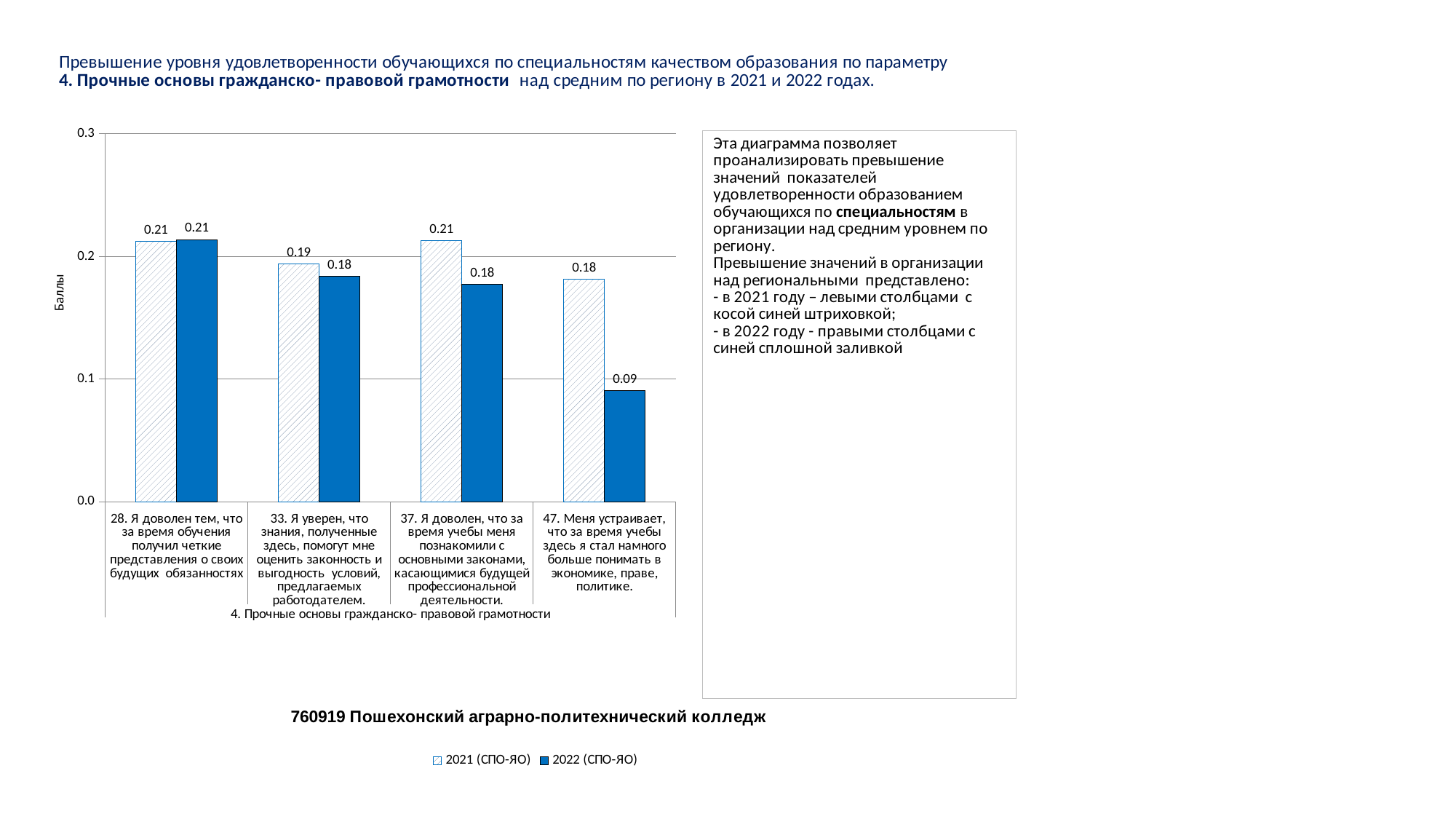
How many categories (questions) are shown on the x axis? 4 Which category has the lowest value for the 2022 (СПО-ЯО) series? 47. Меня устраивает, что за время учебы здесь я стал намного больше понимать в экономике, праве, политике. What is the value for 2022 (СПО-ЯО) for category 37 (Я доволен, что за время учебы меня познакомили с основными законами)? 0.18 What is the label of the y axis? Баллы What is the difference between the 2021 and 2022 values for category 47? 0.09 Is the 2022 value for category 47 greater or less than 0.1? less What type of chart is shown on the slide? bar chart What is the value for 2021 (СПО-ЯО) for category 33 (Я уверен, что знания, полученные здесь, помогут мне оценить законность и выгодность условий, предлагаемых работодателем)? 0.19 For category 37, which series has the larger value, 2021 (СПО-ЯО) or 2022 (СПО-ЯО)? 2021 (СПО-ЯО) How many series does the legend list? 2 What is the value for 2022 (СПО-ЯО) for category 47 (Меня устраивает, что за время учебы здесь я стал намного больше понимать в экономике, праве, политике)? 0.09 What is the difference between the 2021 and 2022 values for category 37? 0.03